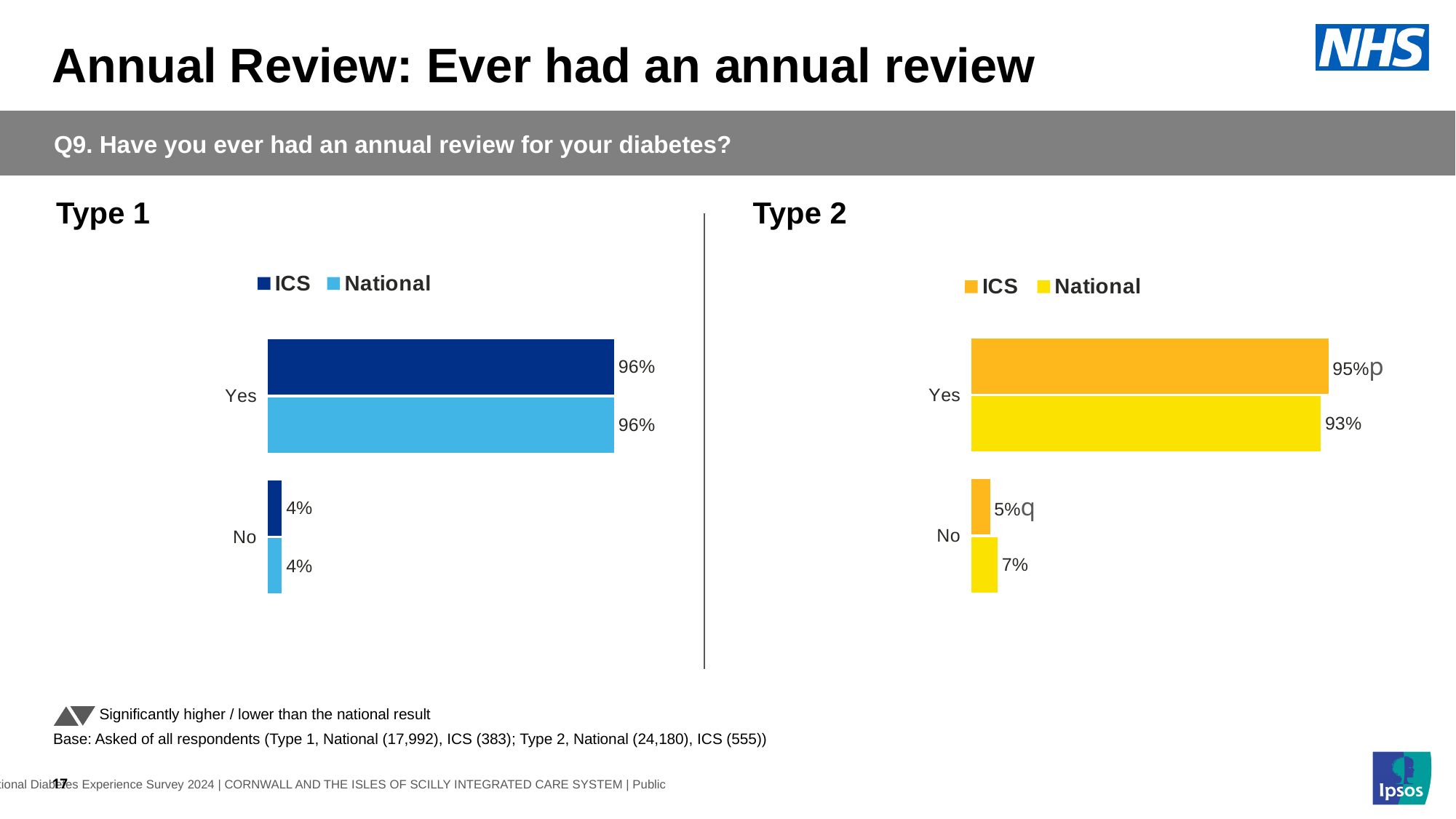
In the Type 2 chart, what is the National value for No? 7% In the Type 2 chart, what is the difference between the ICS and National values for Yes? 2% In the Type 2 chart, what colour represents the National series? Yellow In the Type 1 chart, how many series does the legend list? 2 In the Type 2 chart, how many response categories are shown? 2 In the Type 2 chart, what is the ICS value for Yes? 95% In the Type 1 chart, what is the ICS value for Yes? 96% In the Type 1 chart, what is the National value for No? 4% What kind of chart is the Type 1 chart? Bar chart In the Type 2 chart, what is the difference between the National and ICS values for No? 2% In the Type 2 chart, which is larger for No: the ICS value or the National value? National In the Type 2 chart, what is the National value for Yes? 93%